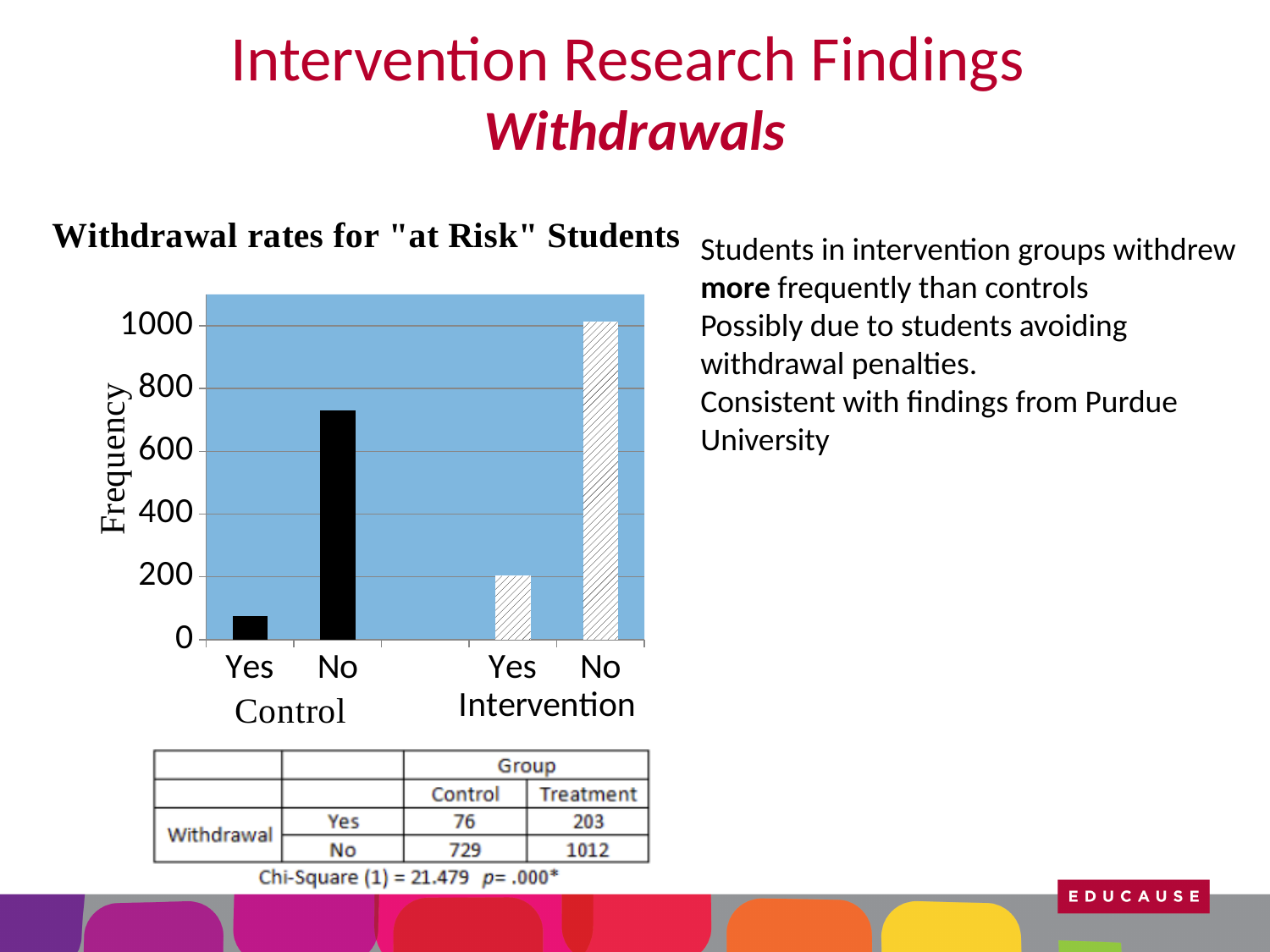
What kind of chart is shown on the slide? bar chart What is the title of the chart? Withdrawal rates for "at Risk" Students According to the table below the chart, what is the frequency of non-withdrawals (No) for the Treatment group? 1012 Is the value for the Intervention No bar greater or less than 1000? greater How many bars are plotted in the chart? 4 Which bar in the chart is the shortest? Control Yes What is the label of the vertical axis of the chart? Frequency Is the value for the Intervention Yes bar greater or less than 400? less Is the value for the Control No bar greater or less than 600? greater Which bar in the chart is the tallest? Intervention No Which is larger, the Control Yes bar or the Intervention Yes bar? Intervention Yes According to the table below the chart, what is the frequency of withdrawals (Yes) for the Control group? 76